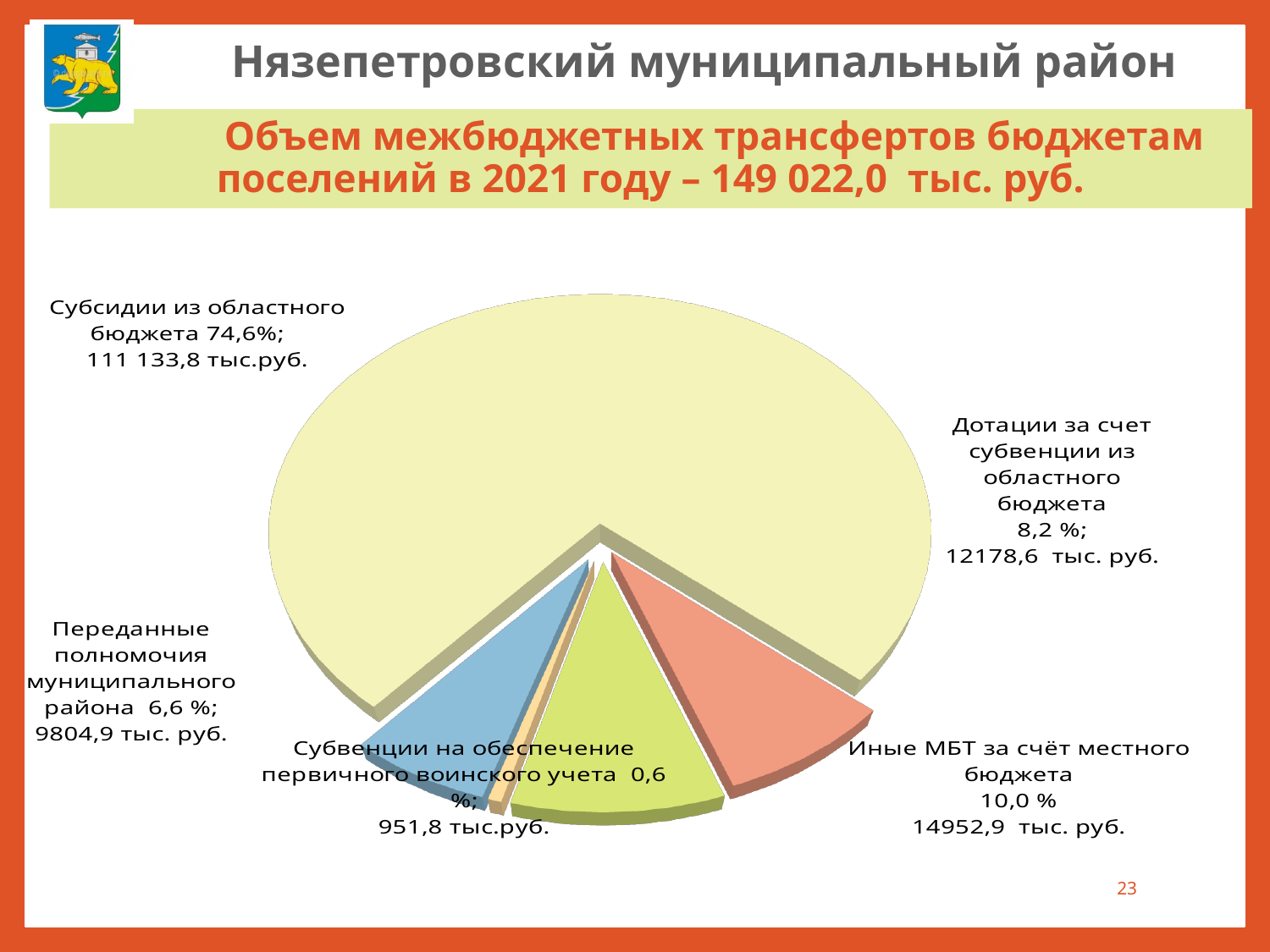
Какой объем иных МБТ за счёт местного бюджета указан на диаграмме? 14952,9 тыс. руб. Какой общий объем межбюджетных трансфертов бюджетам поселений в 2021 году указан в заголовке диаграммы? 149 022,0 тыс. руб. Какой объем субвенций на обеспечение первичного воинского учета указан на диаграмме? 951,8 тыс.руб. Какая категория имеет наименьшую долю на диаграмме? Субвенции на обеспечение первичного воинского учета Какой объем субсидий из областного бюджета указан на диаграмме? 111 133,8 тыс.руб. Какой тип диаграммы показан на слайде? Круговая диаграмма На сколько процентных пунктов доля иных МБТ за счёт местного бюджета больше доли дотаций за счет субвенции из областного бюджета? 1,8 Какая категория имеет наибольшую долю на диаграмме? Субсидии из областного бюджета Какова доля дотаций за счет субвенции из областного бюджета? 8,2 % Сколько секторов (категорий) на круговой диаграмме? 5 Что больше: иные МБТ за счёт местного бюджета или переданные полномочия муниципального района? Иные МБТ за счёт местного бюджета Какова доля субсидий из областного бюджета в объеме межбюджетных трансфертов? 74,6%